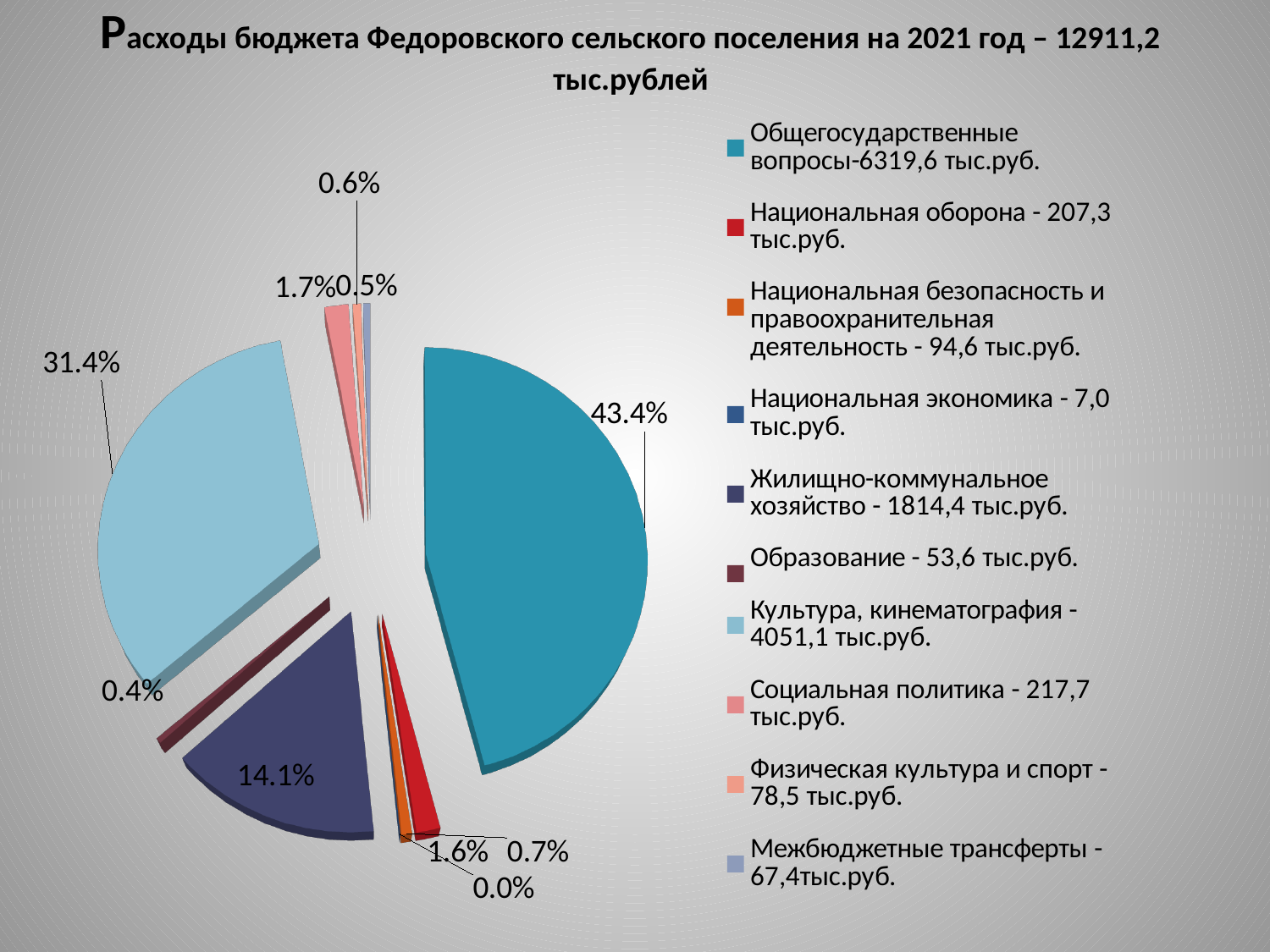
How many categories does the legend of the pie chart list? 10 What share of the pie does Культура, кинематография take? 31.4% Which is larger: the amount for Образование or the amount for Физическая культура и спорт? Физическая культура и спорт Which category has the smallest share of the pie? Национальная экономика What is the difference between the amounts for Общегосударственные вопросы and Культура, кинематография in the legend? 2268,5 тыс.руб. Which category has the largest share of the pie? Общегосударственные вопросы What share of the pie does Жилищно-коммунальное хозяйство take? 14.1% What total budget expenditure for 2021 is stated in the chart title? 12911,2 тыс.рублей According to the legend, what is the amount for Национальная оборона? 207,3 тыс.руб. What share of the pie does Общегосударственные вопросы take? 43.4% According to the legend, what is the amount for Социальная политика? 217,7 тыс.руб. What kind of chart is shown on the slide? pie chart